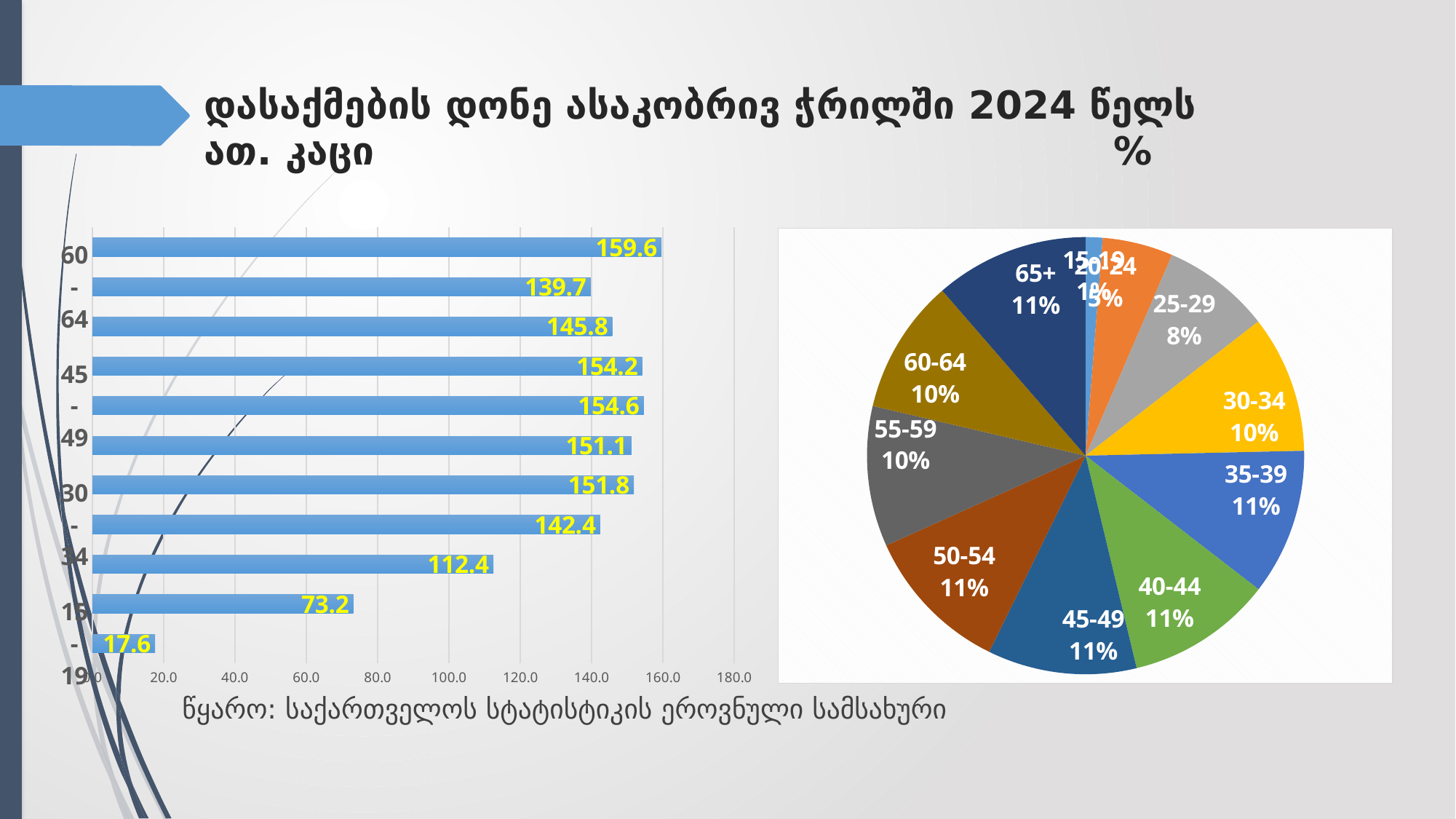
In the bar chart on the left, what is the value of the bottom bar? 17.6 In the bar chart on the left, what is the lowest value shown? 17.6 In the bar chart on the left, what is the difference between the topmost bar (159.6) and the bottom bar (17.6)? 142.0 What kind of chart is the chart on the right side of the slide? pie chart In the pie chart on the right, which slice is larger: 30-34 or 25-29? 30-34 What kind of chart is the chart on the left side of the slide? bar chart In the bar chart on the left, what is the value of the topmost bar? 159.6 In the pie chart on the right, what share does the 20-24 age group have? 5% In the pie chart on the right, which age group has the smallest slice? 15-19 How many bars does the bar chart on the left show? 11 In the pie chart on the right, what share does the 25-29 age group have? 8% In the bar chart on the left, what is the highest value shown? 159.6